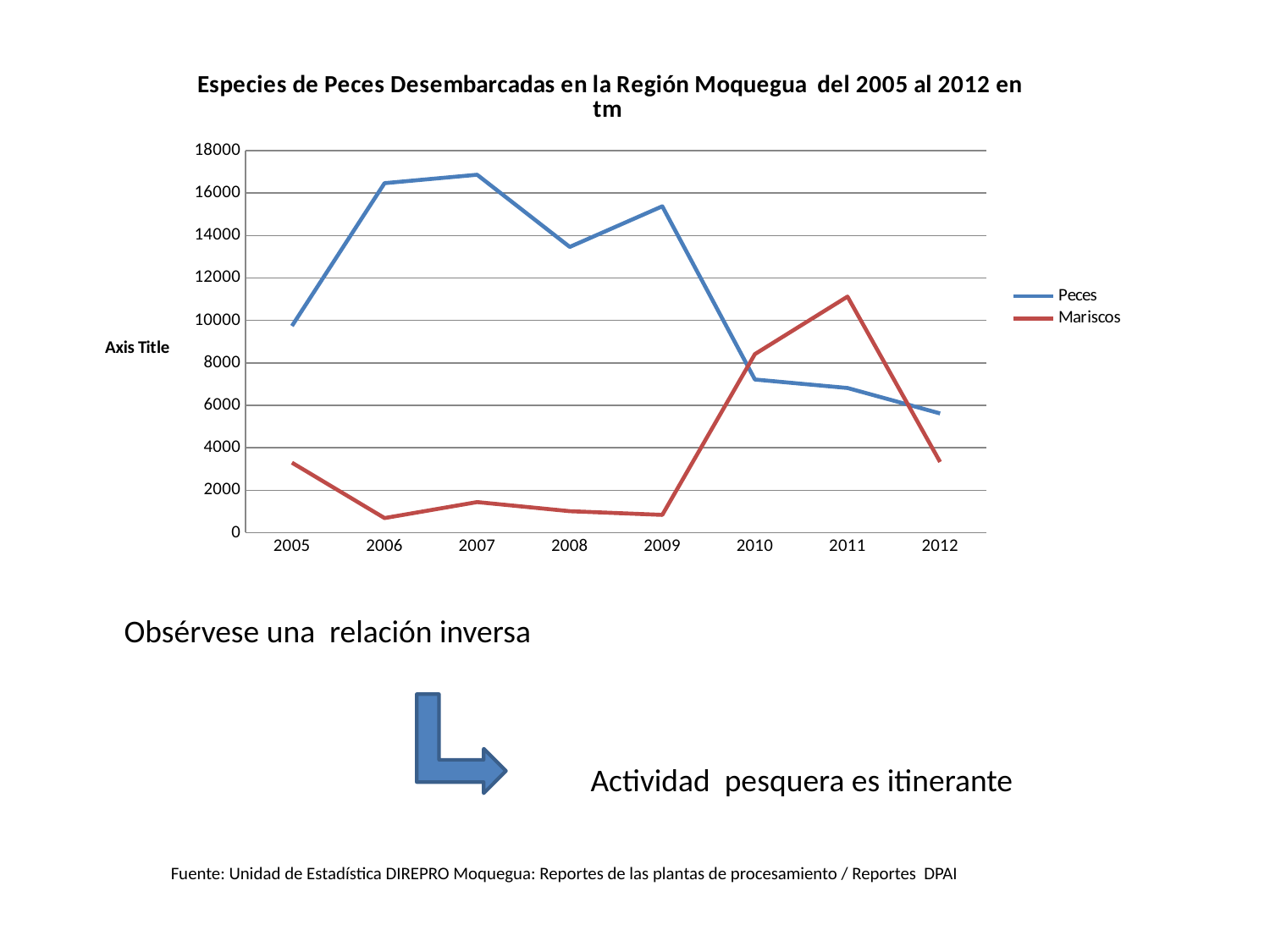
What kind of chart is shown on the slide? line chart In which year does the Mariscos series reach its highest value? 2011 How many series does the legend list? 2 Is the value for Peces in 2007 greater or less than 16000? greater Does the Peces series rise or fall from 2009 to 2012? fall In which year does the Peces series reach its lowest value? 2012 How many years are plotted along the x axis? 8 Is the value for Mariscos in 2011 greater or less than 10000? greater Is the value for Peces in 2005 greater or less than 12000? less In 2012, which series has the larger value, Peces or Mariscos? Peces In 2011, which series has the larger value, Peces or Mariscos? Mariscos